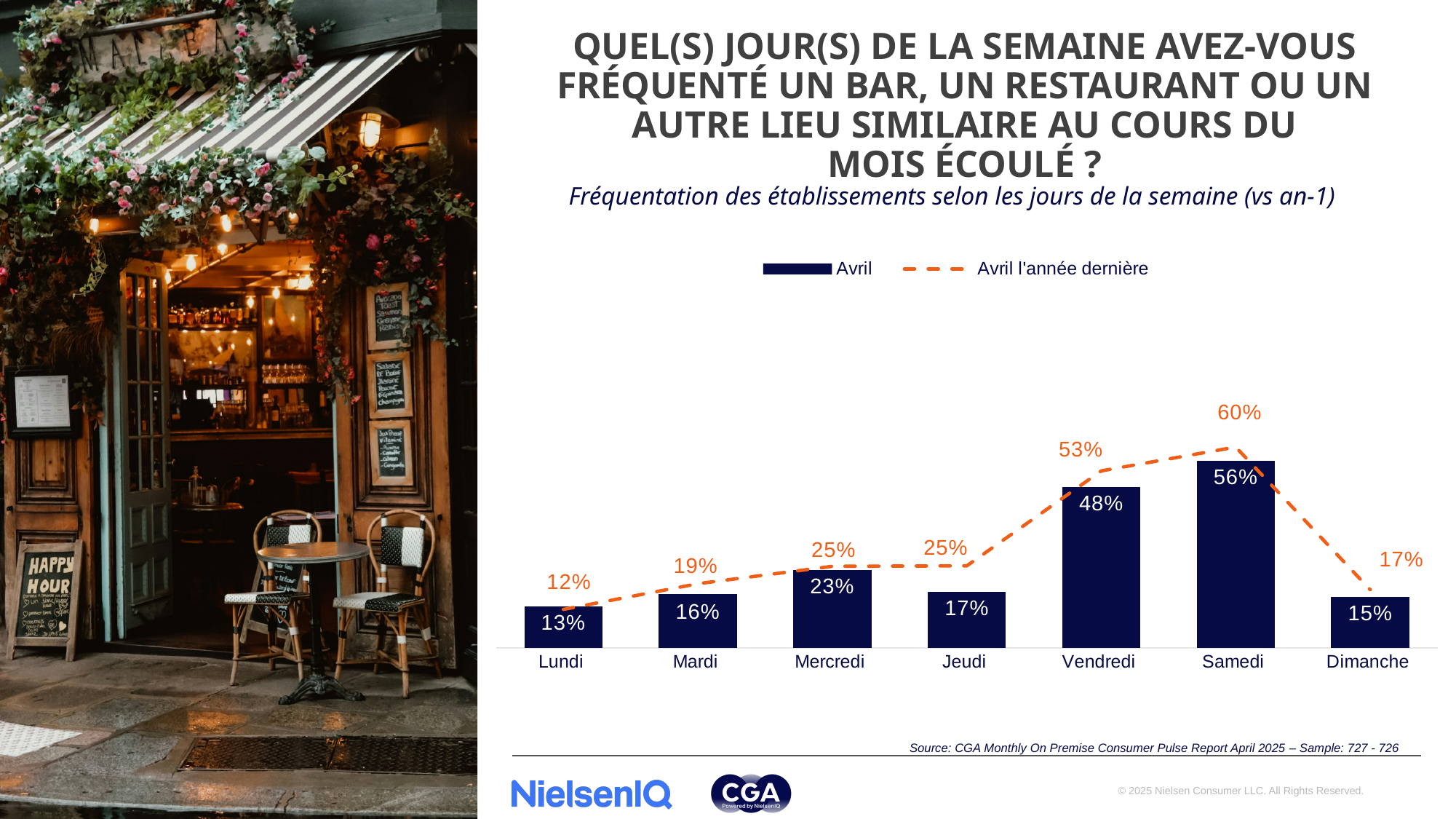
Which is larger for Lundi: the Avril value or the Avril l'année dernière value? Avril What is the difference between the Avril l'année dernière and Avril values for Samedi? 4% Which day has the lowest Avril value? Lundi What is the Avril l'année dernière value for Vendredi? 53% How many series does the legend list? 2 Which day has the highest Avril value? Samedi What is the Avril value for Mercredi? 23% What is the Avril value for Samedi? 56% How many days of the week are shown on the x axis? 7 What kind of chart is used for the Avril series? Bar chart What is the difference between the Avril values for Vendredi and Jeudi? 31% Which series is shown as an orange dashed line? Avril l'année dernière